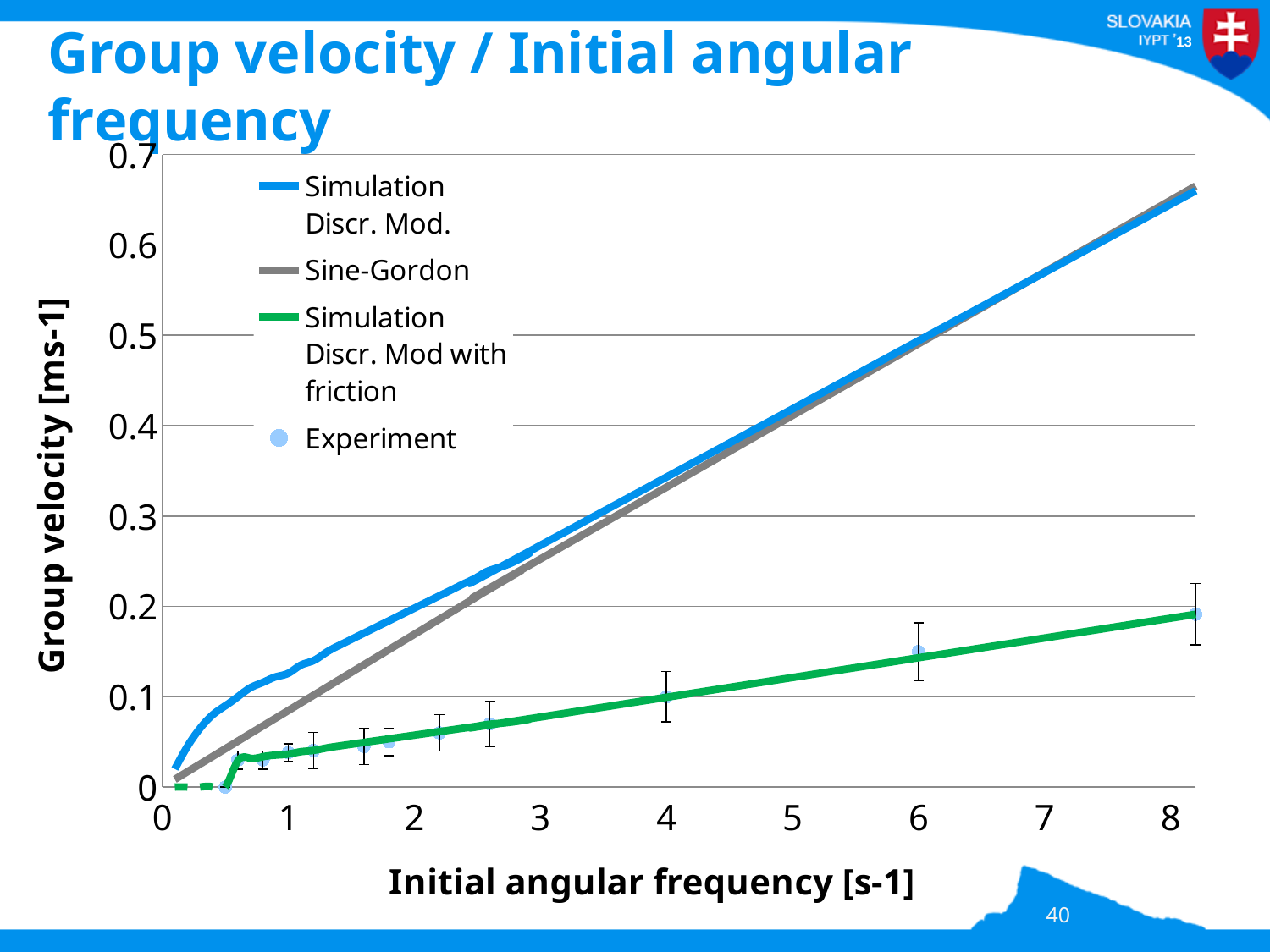
How many series does the legend list? 4 Does the Simulation Discr. Mod. series rise or fall as initial angular frequency increases? rise At an initial angular frequency of 4, which is larger: the Simulation Discr. Mod. series or the Simulation Discr. Mod with friction series? Simulation Discr. Mod. Which line series has the lowest value at an initial angular frequency of 8? Simulation Discr. Mod with friction Does the Simulation Discr. Mod with friction series rise or fall as initial angular frequency increases? rise Is the value of the Simulation Discr. Mod with friction series at an initial angular frequency of 6 greater or less than 0.2? less What is the title of the chart? Group velocity / Initial angular frequency At an initial angular frequency of 8, which is larger: the Sine-Gordon series or the Simulation Discr. Mod with friction series? Sine-Gordon What is the label of the y axis? Group velocity [ms-1] Is the value of the Simulation Discr. Mod. series at an initial angular frequency of 8 greater or less than 0.6? greater Is the value of the Sine-Gordon series at an initial angular frequency of 2 greater or less than 0.1? greater What kind of chart is shown on the slide? line chart